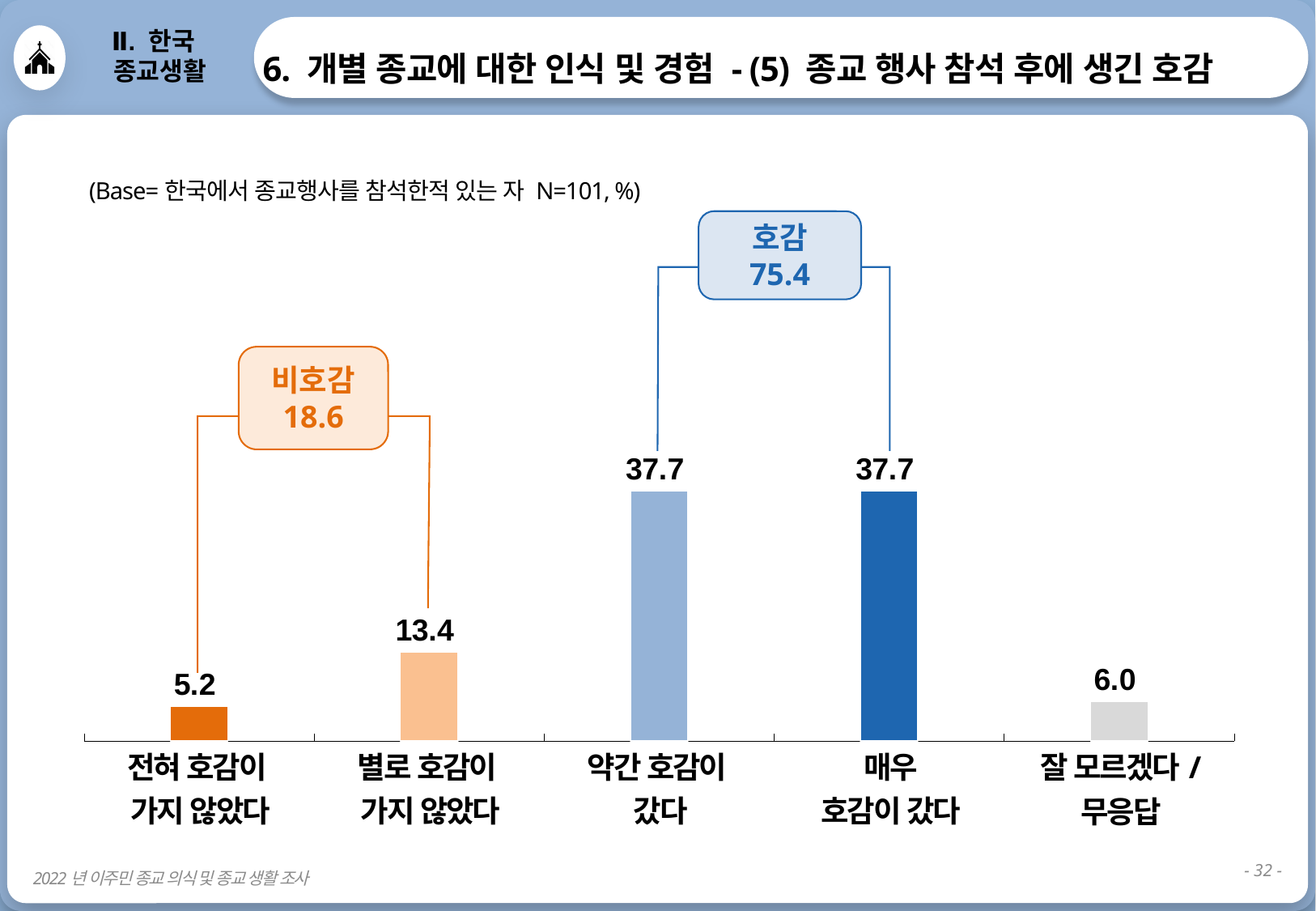
What kind of chart is shown on the slide? bar chart What is the value for '약간 호감이 갔다'? 37.7 What is the difference between the values for '별로 호감이 가지 않았다' and '전혀 호감이 가지 않았다'? 8.2 What is the value for '전혀 호감이 가지 않았다'? 5.2 What is the value for '잘 모르겠다 / 무응답'? 6.0 What is the combined value shown for the '비호감' group? 18.6 Which category has the lowest value? 전혀 호감이 가지 않았다 How many categories are shown on the x axis? 5 What is the value for '별로 호감이 가지 않았다'? 13.4 Which is larger, the value for '별로 호감이 가지 않았다' or the value for '잘 모르겠다 / 무응답'? 별로 호감이 가지 않았다 What is the combined value shown for the '호감' group? 75.4 What is the difference between the values for '매우 호감이 갔다' and '별로 호감이 가지 않았다'? 24.3